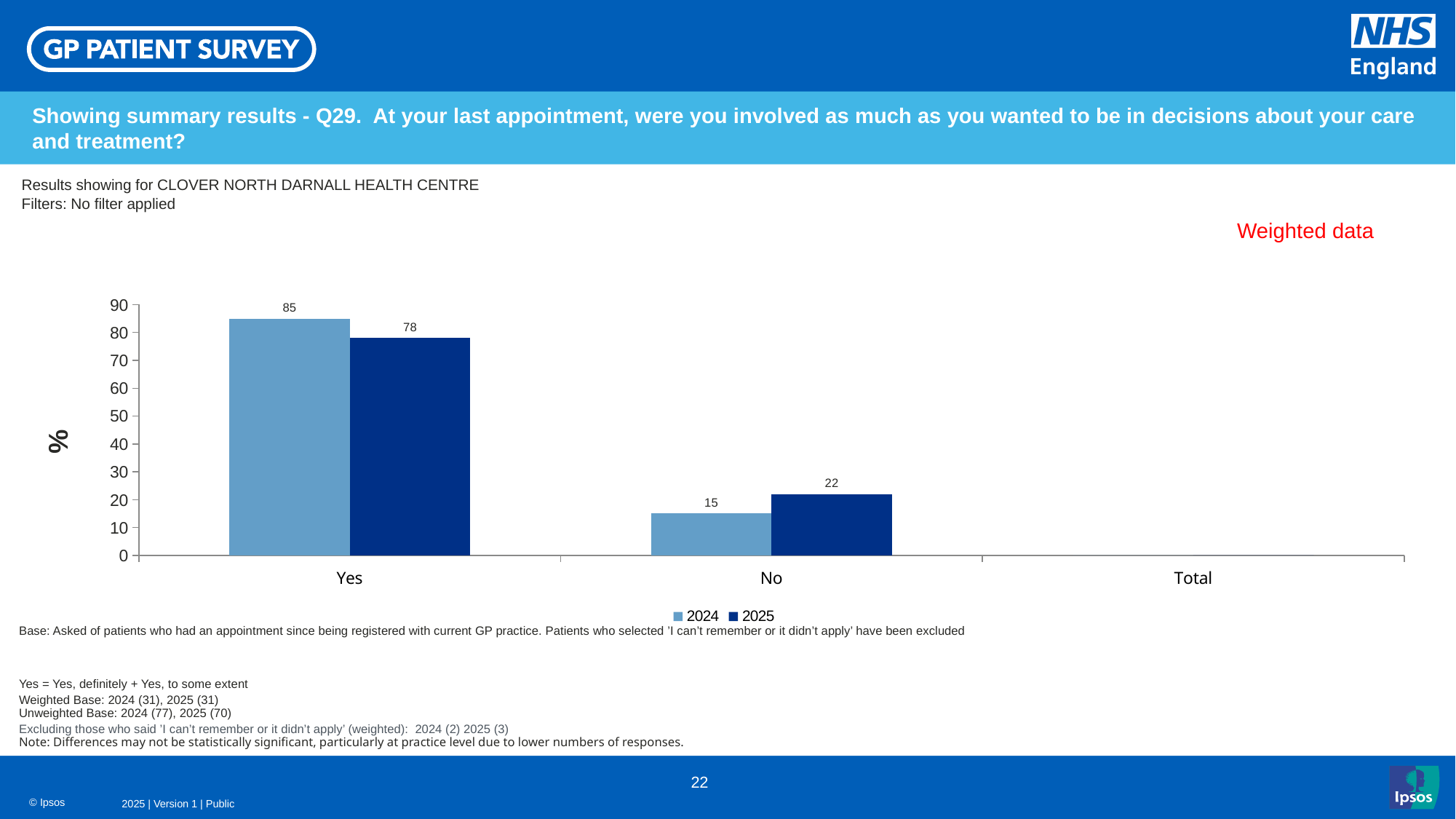
Which category has the highest 2025 value? Yes Which is larger for No: the 2024 value or the 2025 value? 2025 What is the difference between the 2024 and 2025 values for Yes? 7 What is the 2025 value for Yes? 78 Which category has the lowest 2024 value? No What is the 2025 value for No? 22 What is the 2024 value for Yes? 85 What is the 2024 value for No? 15 How many series does the legend list? 2 Is the 2025 value for Yes greater or less than 70? greater What kind of chart is shown on the slide? Bar chart What is the label on the vertical axis? %